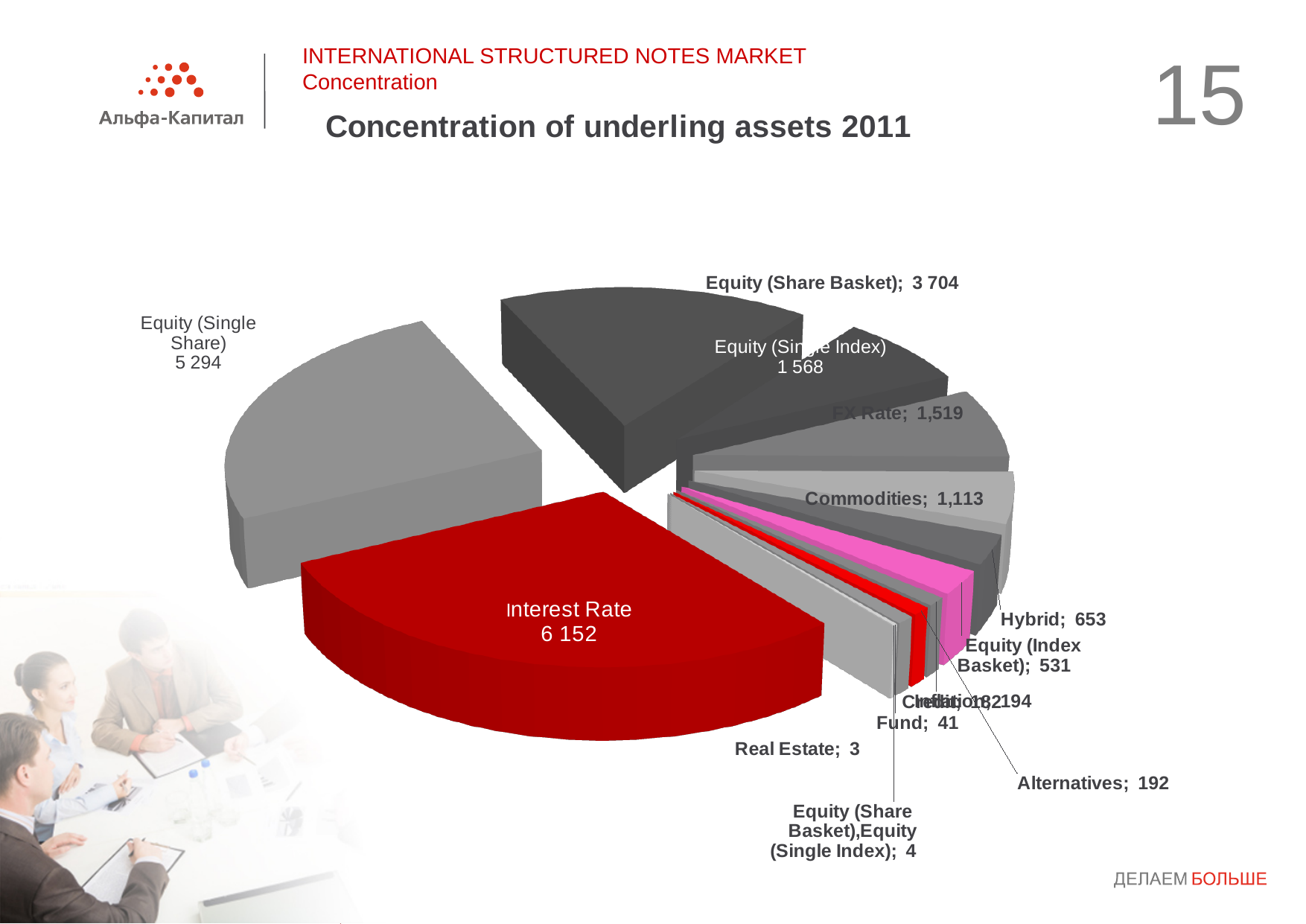
What is the value for Equity (Share Basket)? 3 704 Which is larger, the value for FX Rate or the value for Commodities? FX Rate What is the value for Equity (Single Share)? 5 294 What is the value for Commodities? 1,113 What is the value for FX Rate? 1,519 What type of chart is shown on the slide? Pie chart What is the difference between the values for Interest Rate and Equity (Single Share)? 858 What is the title of the chart? Concentration of underling assets 2011 What is the value for Hybrid? 653 Which category has the smallest value shown? Real Estate Which category has the largest slice of the pie? Interest Rate What is the value for Interest Rate? 6 152